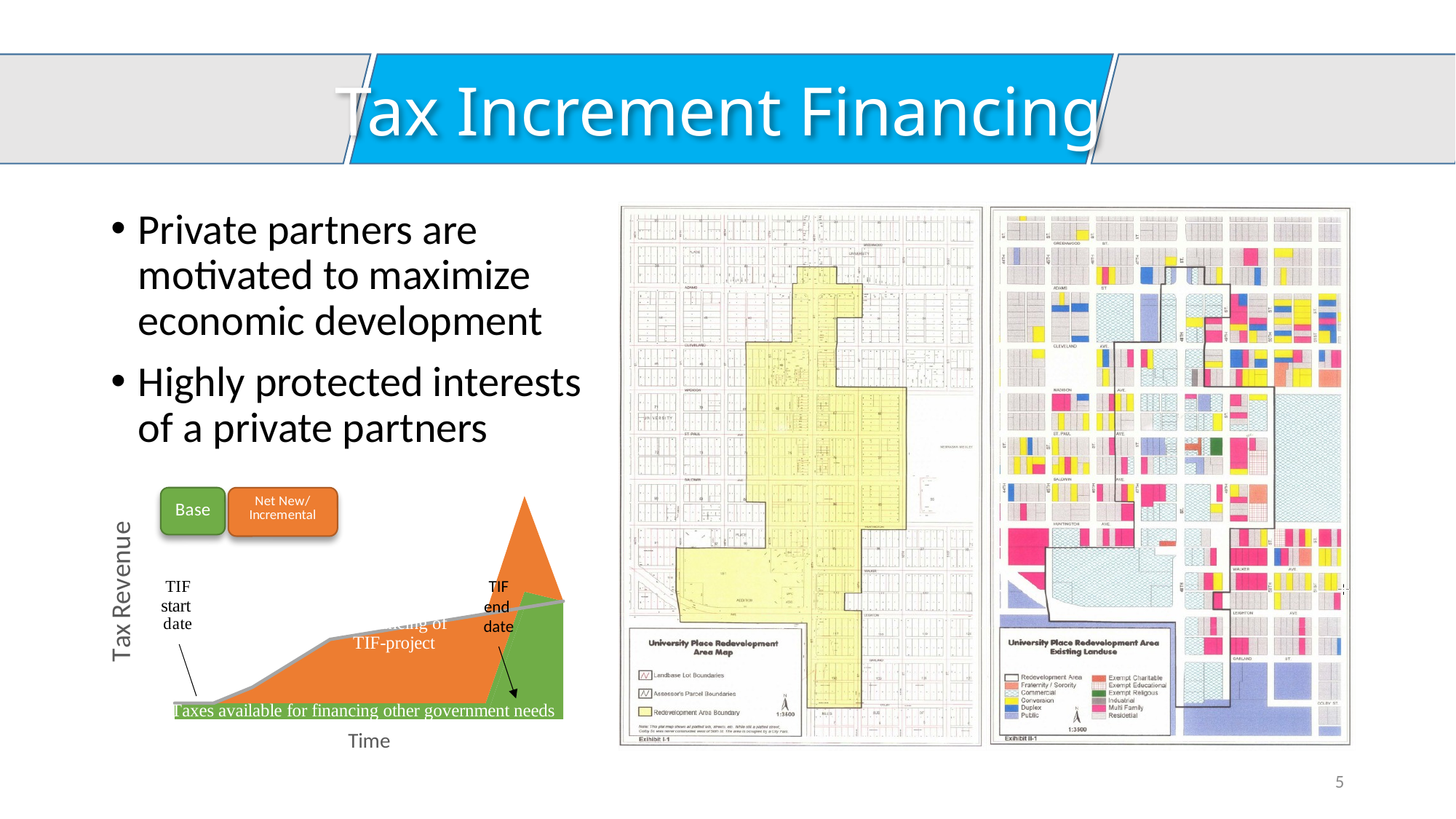
How many series does the legend of the Tax Revenue chart list? 2 In the Tax Revenue chart, does the grey line rise or fall along the Time axis from the TIF start date to the TIF end date? rise What are the axis labels of the Tax Revenue chart (y axis and x axis)? Tax Revenue (y axis); Time (x axis) In the Tax Revenue chart, does the Net New/Incremental area grow or shrink between the TIF start date and the TIF end date? grow What are the two legend entries of the Tax Revenue chart? Base; Net New/Incremental What kind of chart is the Tax Revenue vs Time chart on the left of the slide? area chart